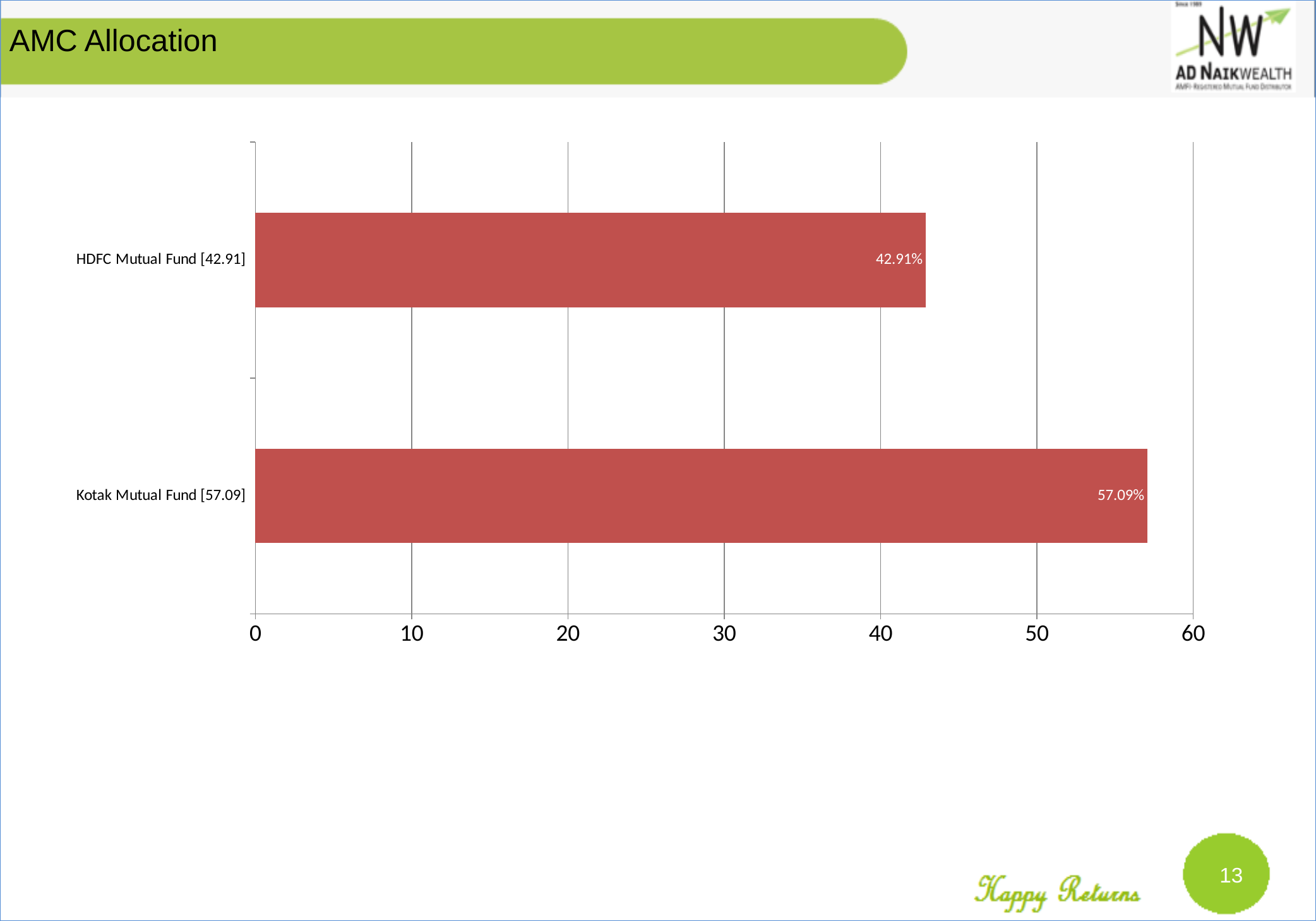
What kind of chart is shown on the slide? Bar chart Which is larger, the allocation for HDFC Mutual Fund or for Kotak Mutual Fund? Kotak Mutual Fund What is the value shown for Kotak Mutual Fund? 57.09% Is the value for Kotak Mutual Fund greater or less than 60? less Which fund has the highest allocation? Kotak Mutual Fund What is the value shown for HDFC Mutual Fund? 42.91% Which fund has the lowest allocation? HDFC Mutual Fund What is the total of the two allocations shown? 100% What is the title of the slide? AMC Allocation What is the difference between the Kotak Mutual Fund and HDFC Mutual Fund allocations? 14.18% Is the value for HDFC Mutual Fund greater or less than 40? greater How many funds are shown in the chart? 2